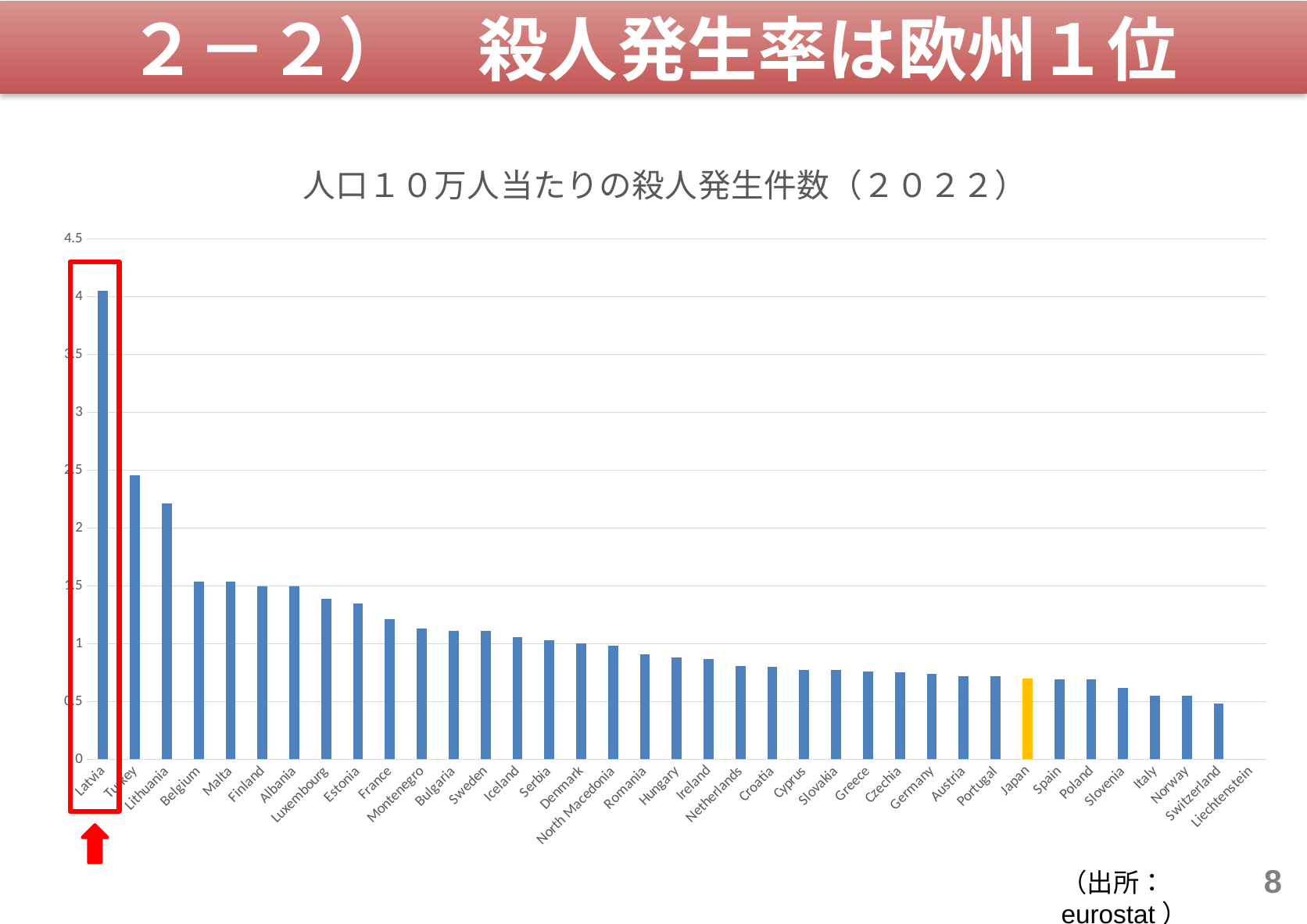
Is the value for Hungary greater or less than 1? less Do the values rise or fall moving from left to right along the x axis? fall Is the value for Luxembourg greater or less than 1.5? less Is the value for Japan greater or less than 1? less Which country's bar is highlighted in a different colour (yellow) from the others? Japan Which country has the lowest homicide rate in the chart? Liechtenstein How many countries are plotted in the chart? 37 Which has the larger value, Turkey or Lithuania? Turkey Which country has the highest homicide rate in the chart? Latvia What kind of chart is shown on the slide? bar chart